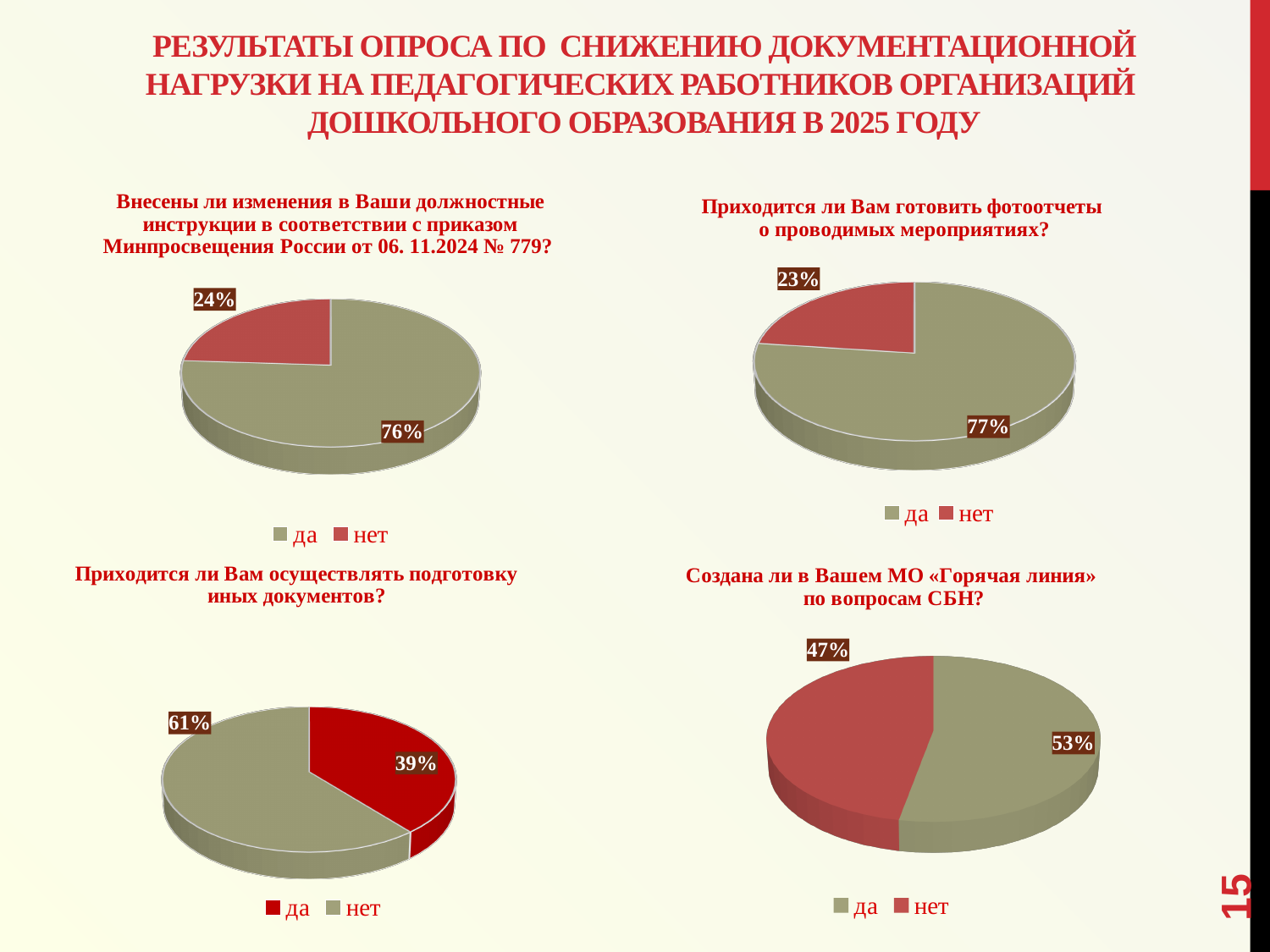
On the bottom-left pie chart (about preparing other documents), what share of respondents answered "нет"? 61% On the top-left pie chart (about changes to job descriptions under order № 779), what is the difference in percentage points between the "да" and "нет" shares? 52 On the bottom-right pie chart (about a "Горячая линия" on СБН issues), what share of respondents answered "да"? 53% How many charts are shown on this slide? 4 On the top-right pie chart (about preparing photo reports of events), what share of respondents answered "да"? 77% On the top-left pie chart (about changes to job descriptions under order № 779), what share of respondents answered "нет"? 24% What type of chart is used for the four charts on this slide? Pie chart On the bottom-left pie chart (about preparing other documents), which answer has the largest share? нет On the bottom-left pie chart (about preparing other documents), what share of respondents answered "да"? 39% On the bottom-right pie chart (about a "Горячая линия" on СБН issues), which answer has the larger share, "да" or "нет"? да On the top-left pie chart (about changes to job descriptions under order № 779), what share of respondents answered "да"? 76% On the top-right pie chart (about preparing photo reports of events), what share of respondents answered "нет"? 23%